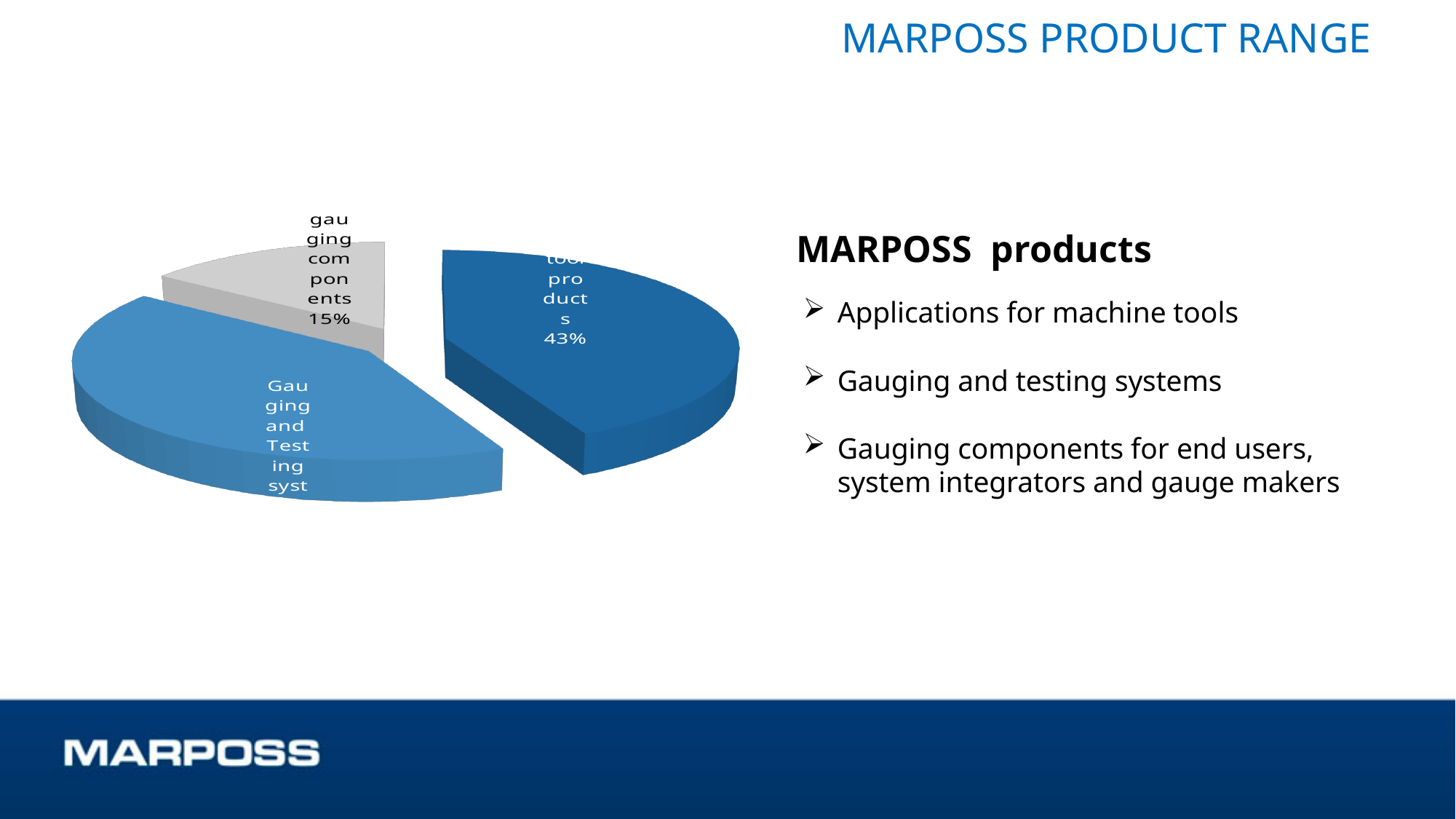
What colour is the tool products slice? dark blue How many slices does the pie chart have? 3 What is the difference in percentage points between the tool products slice (43%) and the gauging components slice (15%)? 28 What kind of chart is shown on the slide? pie chart Which is larger, the tool products slice or the gauging components slice? tool products What share of the pie does the gauging components slice represent? 15% What percentage is shown for the gauging components slice? 15% Which slice of the pie chart is the smallest? gauging components What colour is the gauging components slice? grey What percentage is shown for the tool products slice? 43%